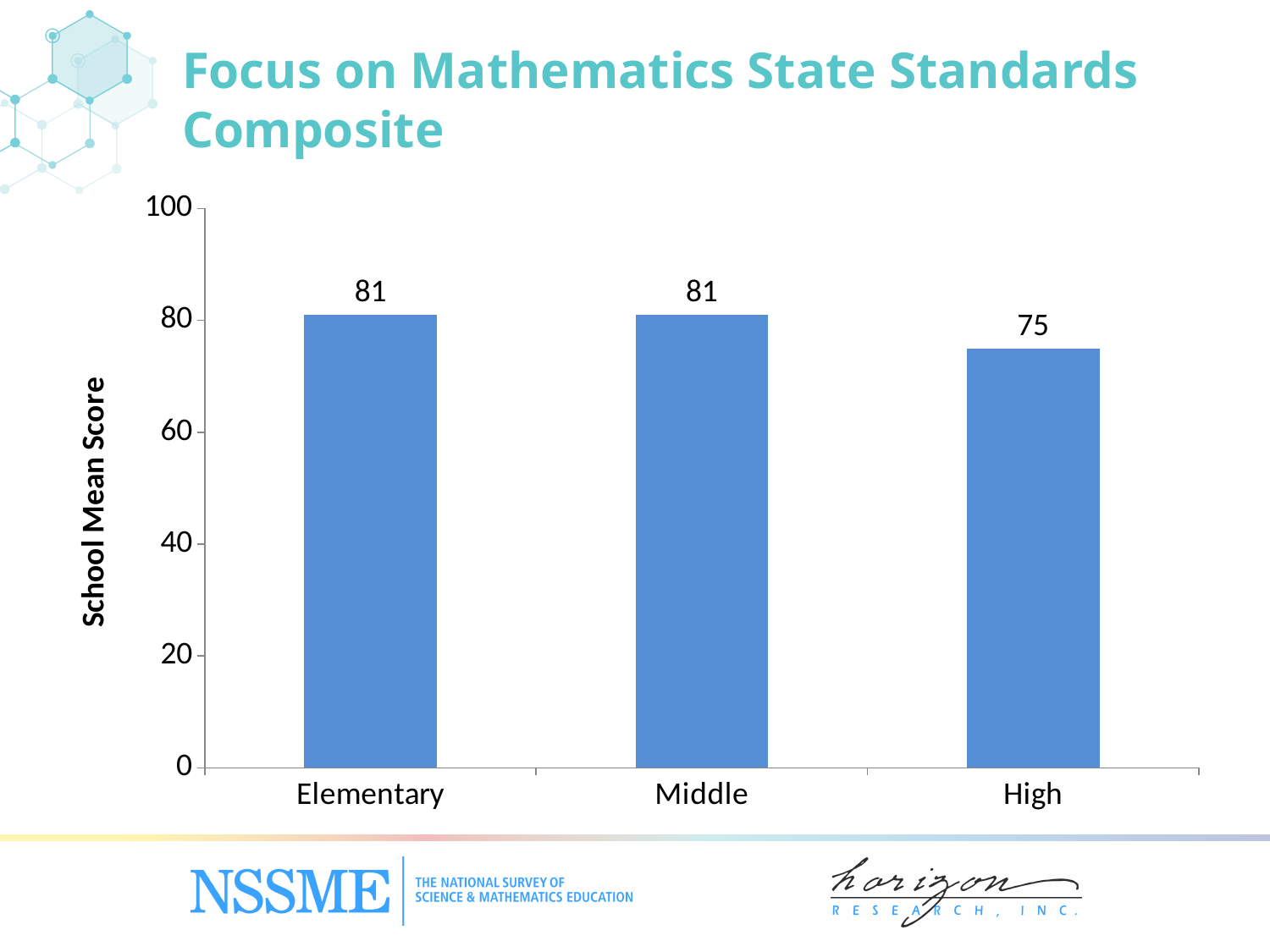
Which school level has the lowest school mean score? High What is the school mean score for Elementary? 81 What is the title of the slide? Focus on Mathematics State Standards Composite What is the difference between the school mean scores for Elementary and High? 6 What kind of chart is shown on the slide? bar chart What is the school mean score for High? 75 Which is larger, the school mean score for Middle or for High? Middle What is the label of the vertical axis? School Mean Score Is the value for High greater or less than 80? less Is the value for Elementary greater or less than 60? greater How many school levels are shown on the chart? 3 What is the school mean score for Middle? 81